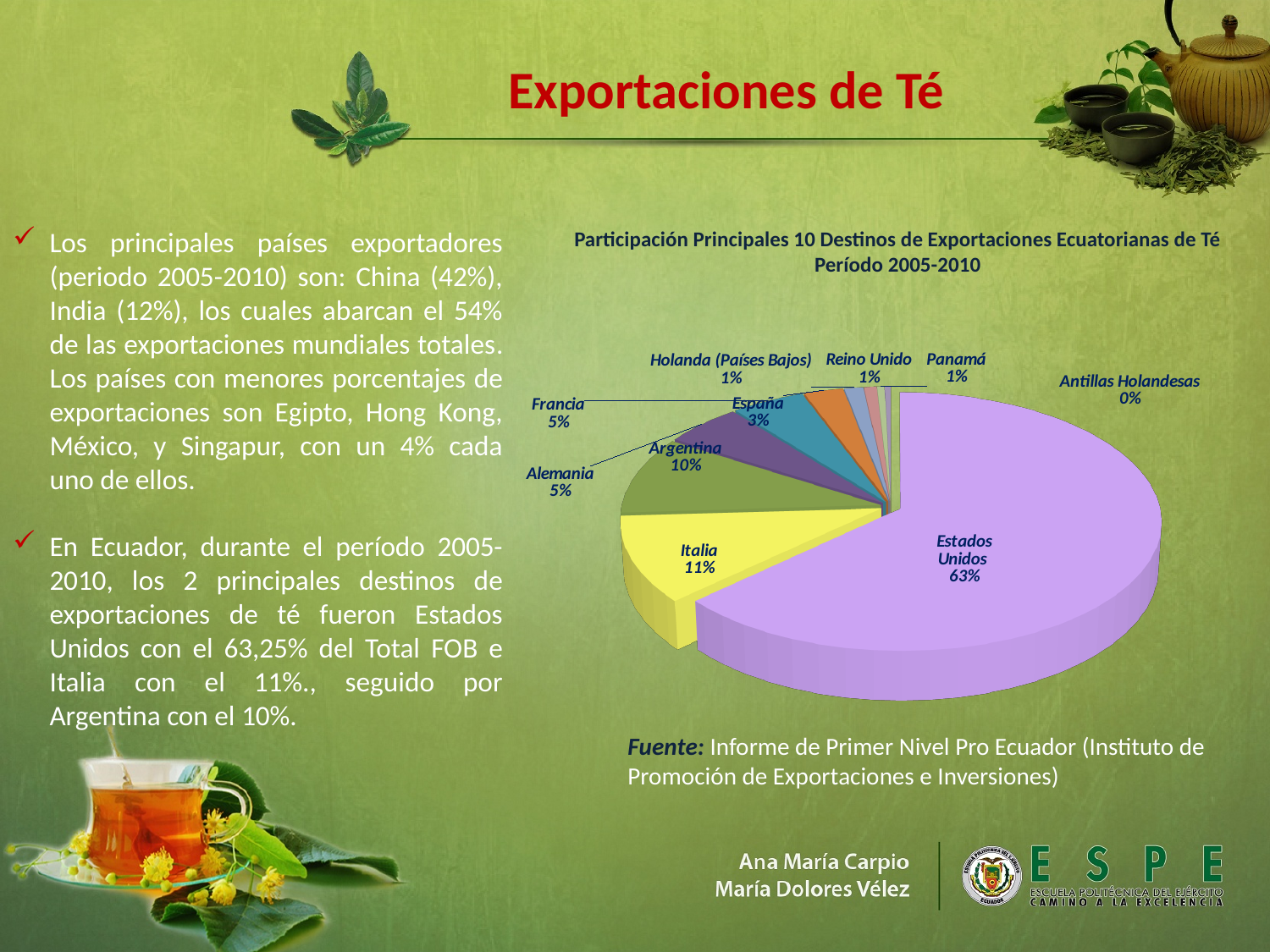
What is the title of the pie chart? Participación Principales 10 Destinos de Exportaciones Ecuatorianas de Té Período 2005-2010 What share of the pie does Estados Unidos hold? 63% Which destination has the smallest share of the pie? Antillas Holandesas What is the value shown for Argentina? 10% What is the value shown for España? 3% What is the difference between the shares of Estados Unidos and Italia? 52% Which has a larger share, Italia or Argentina? Italia What is the value shown for Antillas Holandesas? 0% How many destinations are shown in the pie chart? 10 Which destination has the largest share of the pie? Estados Unidos What is the value shown for Italia? 11% What kind of chart is shown on the slide? pie chart